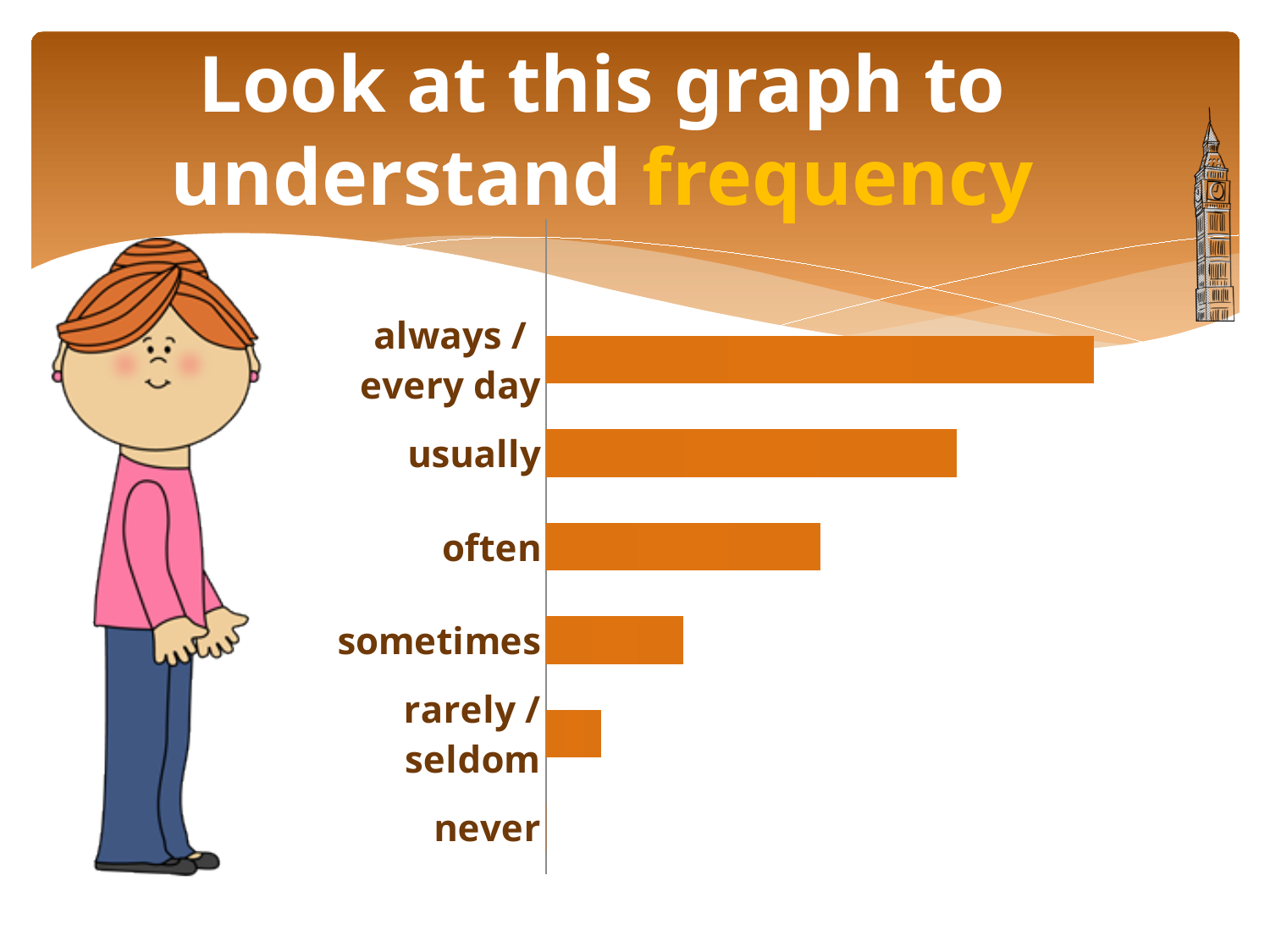
What colour are the bars in the chart? orange Which category has the longer bar, sometimes or rarely / seldom? sometimes Do the bars get longer or shorter going down the chart from 'always / every day' to 'never'? shorter Which category has the longest bar? always / every day Which category has the longer bar, usually or often? usually Which category has the shortest visible bar? rarely / seldom How many categories are listed on the chart's vertical axis? 6 Which category has the shortest bar (no visible bar at all)? never Which category has the longer bar, often or sometimes? often What kind of chart is shown on the slide? bar chart Which category is listed directly below 'often' on the chart? sometimes